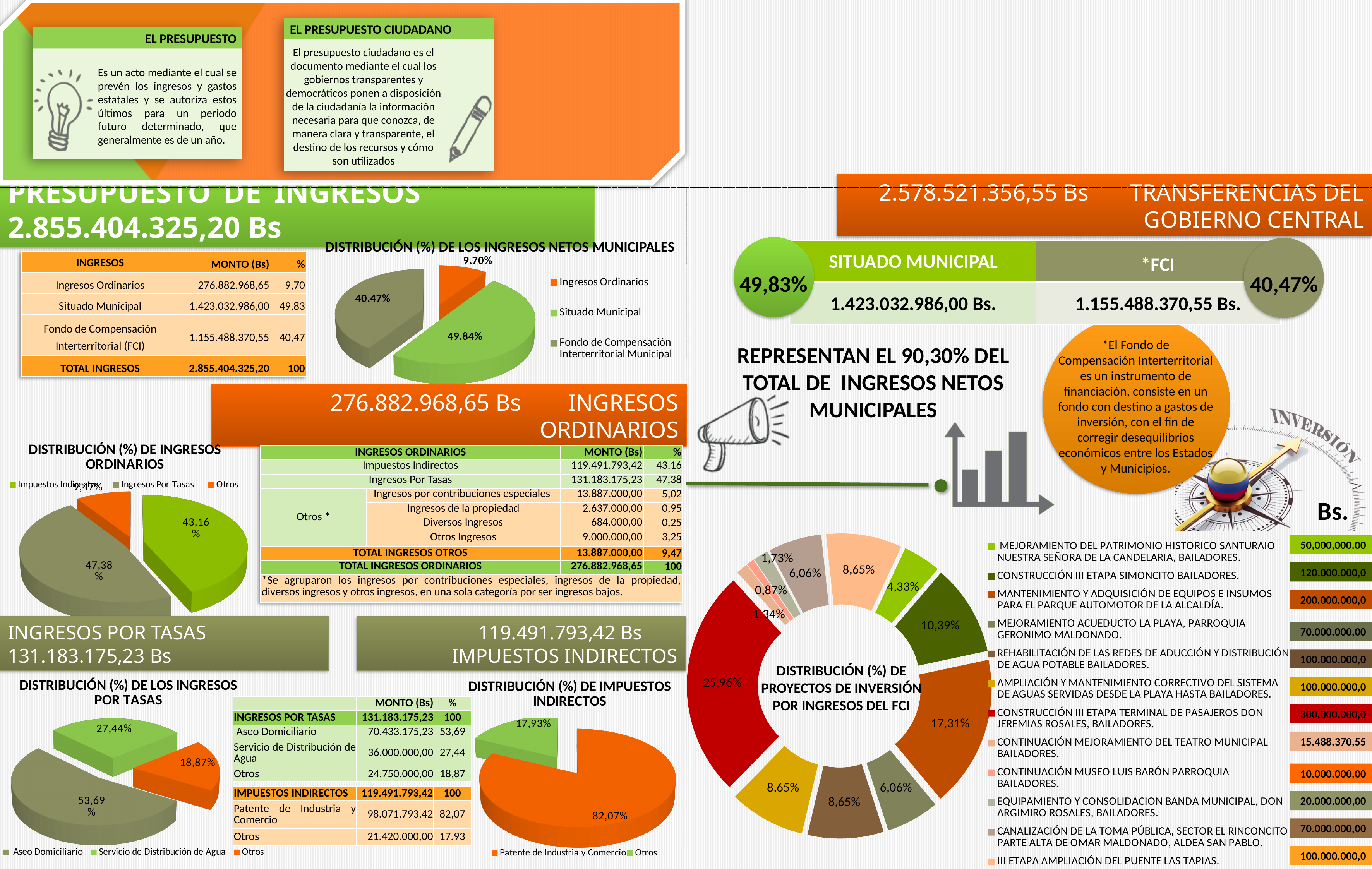
In the chart titled 'DISTRIBUCIÓN (%) DE IMPUESTOS INDIRECTOS', what percentage is shown for Patente de Industria y Comercio? 82,07% How many entries does the legend of the chart titled 'DISTRIBUCIÓN (%) DE IMPUESTOS INDIRECTOS' list? 2 In the chart titled 'DISTRIBUCIÓN (%) DE LOS INGRESOS POR TASAS', what percentage is shown for Aseo Domiciliario? 53,69% In the chart titled 'DISTRIBUCIÓN (%) DE LOS INGRESOS NETOS MUNICIPALES', what percentage is shown for Situado Municipal? 49.84% In the chart titled 'DISTRIBUCIÓN (%) DE INGRESOS ORDINARIOS', which is larger, Impuestos Indirectos or Ingresos Por Tasas? Ingresos Por Tasas In the chart titled 'DISTRIBUCIÓN (%) DE INGRESOS ORDINARIOS', what percentage is shown for Ingresos Por Tasas? 47,38% In the chart titled 'DISTRIBUCIÓN (%) DE LOS INGRESOS NETOS MUNICIPALES', how many slices does the pie have? 3 What kind of chart is 'DISTRIBUCIÓN (%) DE INGRESOS ORDINARIOS'? Pie chart In the chart titled 'DISTRIBUCIÓN (%) DE LOS INGRESOS POR TASAS', what is the difference in percentage points between Servicio de Distribución de Agua and Otros? 8,57 In the chart titled 'DISTRIBUCIÓN (%) DE LOS INGRESOS NETOS MUNICIPALES', which category has the smallest share? Ingresos Ordinarios In the doughnut chart titled 'DISTRIBUCIÓN (%) DE PROYECTOS DE INVERSIÓN POR INGRESOS DEL FCI', how many projects does the legend list? 12 In the doughnut chart titled 'DISTRIBUCIÓN (%) DE PROYECTOS DE INVERSIÓN POR INGRESOS DEL FCI', what is the largest percentage shown? 25,96%